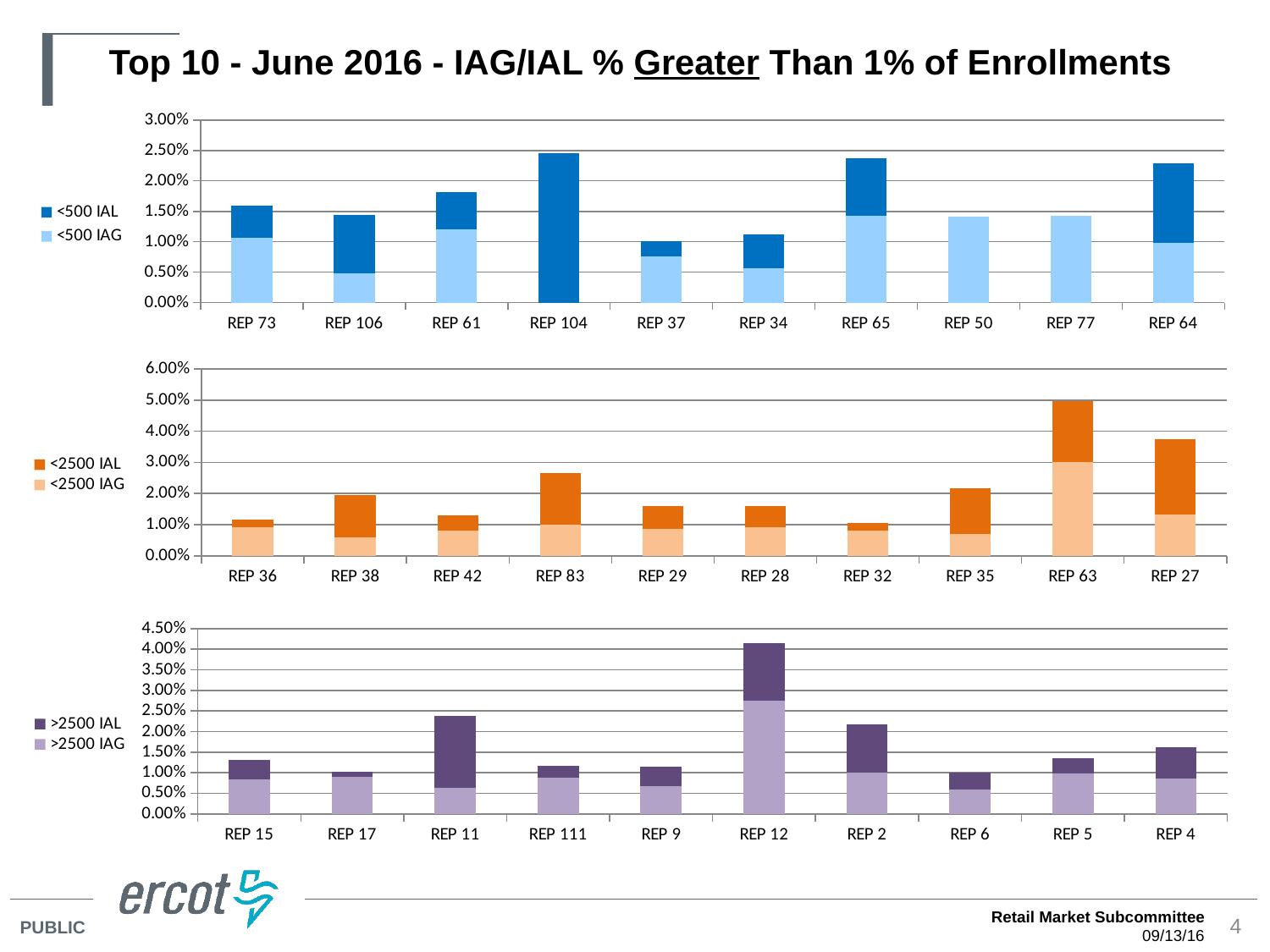
In the middle chart, is the total value for REP 27 greater or less than 3.00%? greater How many series does the legend of the bottom chart list? 2 What kind of chart is the top chart on the slide? bar chart In the bottom chart, which REP has the highest total bar? REP 12 In the middle chart, which REP has the highest total bar? REP 63 In the bottom chart, is the total value for REP 17 greater or less than 1.50%? less What are the two legend entries of the top chart? <500 IAL and <500 IAG In the bottom chart, is the total value for REP 11 greater or less than 2.00%? greater How many REP categories are shown on the x axis of the middle chart? 10 In the middle chart, which has the larger total bar, REP 63 or REP 27? REP 63